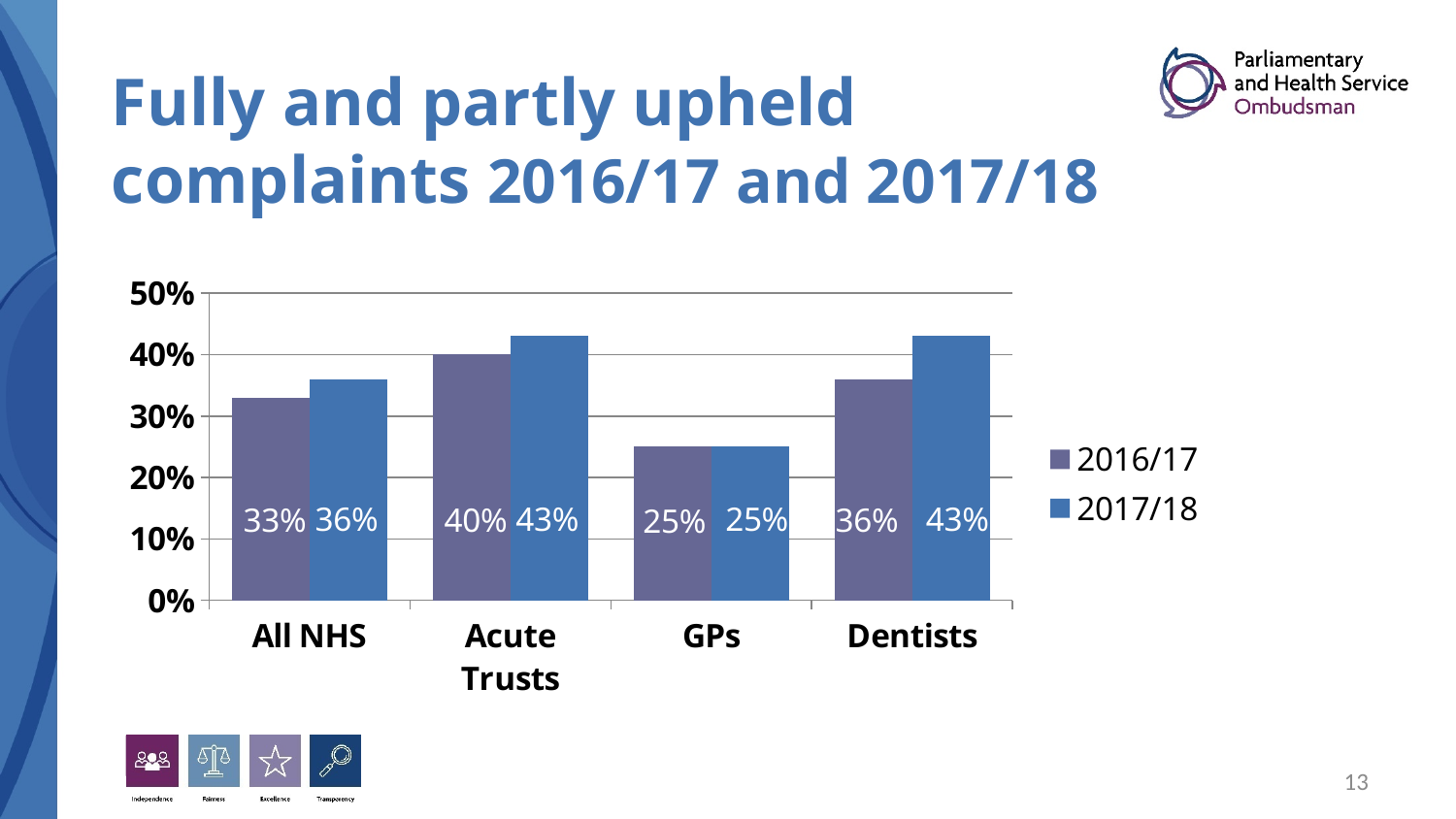
How many series does the legend list? 2 What is the value for Dentists in 2017/18? 43% What is the difference between the Acute Trusts and All NHS values in 2016/17? 7% Which is larger: the 2017/18 value for Acute Trusts or the 2017/18 value for All NHS? Acute Trusts Which category has the highest value in 2016/17? Acute Trusts What is the difference between the 2017/18 and 2016/17 values for Dentists? 7% What is the value for All NHS in 2017/18? 36% How many categories are shown on the x axis? 4 Which category has the lowest value in 2017/18? GPs What is the title of the slide? Fully and partly upheld complaints 2016/17 and 2017/18 What is the value for GPs in 2016/17? 25% What kind of chart is shown on the slide? Bar chart